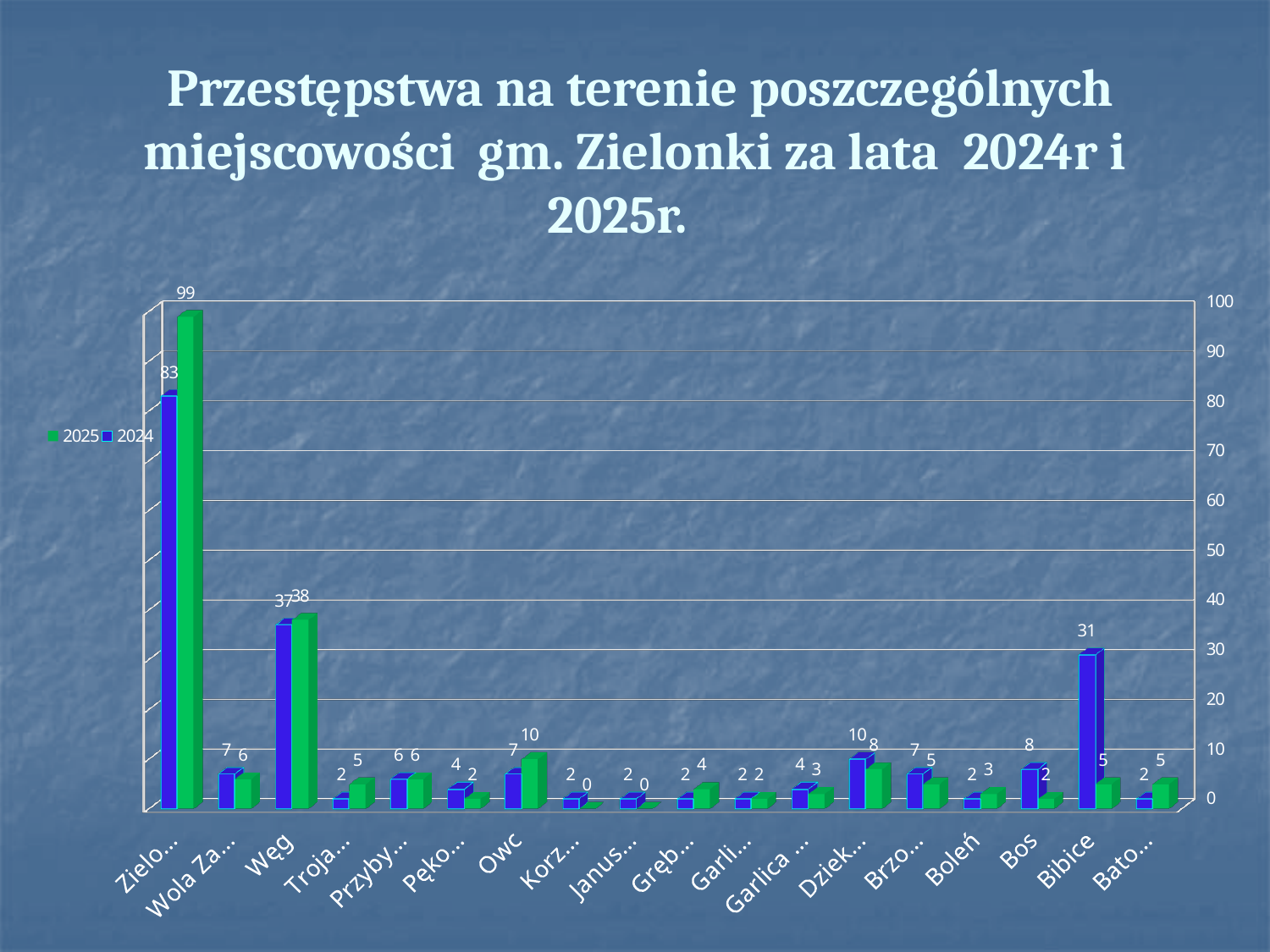
What is the 2025 value for Owc? 10 What is the difference between the 2024 and 2025 values for Bibice? 26 How many categories are shown on the x axis? 18 What is the difference between the 2024 and 2025 values for Bos? 6 What is the 2025 value for Boleń? 3 What is the 2024 value for Bos? 8 For Węg, which year has the larger value, 2024 or 2025? 2025 How many series does the legend list? 2 Which category has the highest 2025 value? Zielo… Is the 2024 value for Bibice greater or less than 20? greater What is the 2024 value for Bibice? 31 What is the 2025 value for Węg? 38